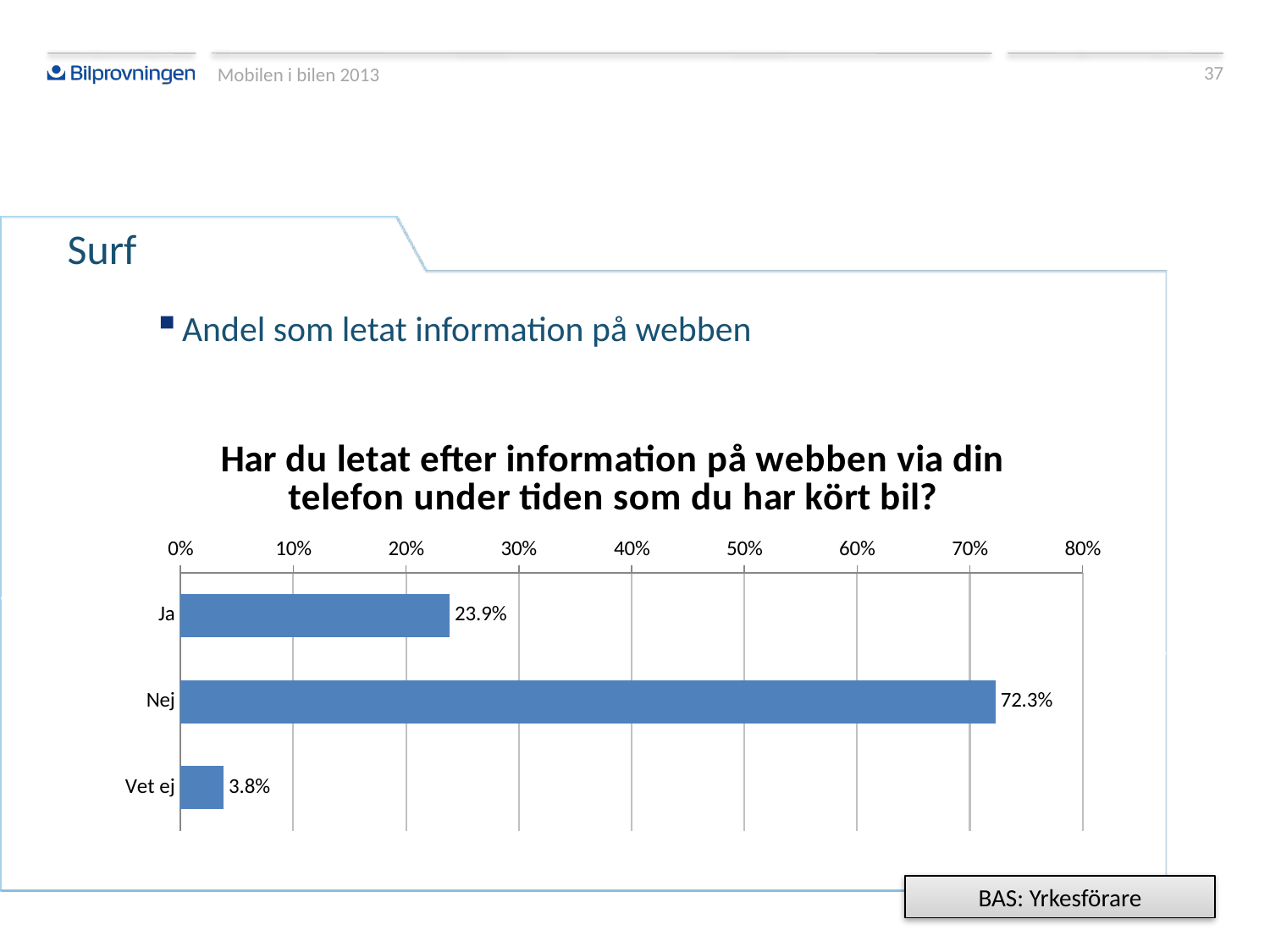
Is the value for "Nej" greater or less than 70%? greater Which category has the highest value? Nej Which is larger, the value for "Ja" or the value for "Vet ej"? Ja What is the title of the chart? Har du letat efter information på webben via din telefon under tiden som du har kört bil? What is the difference between the values for "Nej" and "Ja"? 48.4% What is the value for "Nej"? 72.3% Which category has the lowest value? Vet ej What is the difference between the values for "Ja" and "Vet ej"? 20.1% How many categories are shown in the chart? 3 What kind of chart is shown on the slide? bar chart What is the value for "Vet ej"? 3.8% What is the value for "Ja"? 23.9%